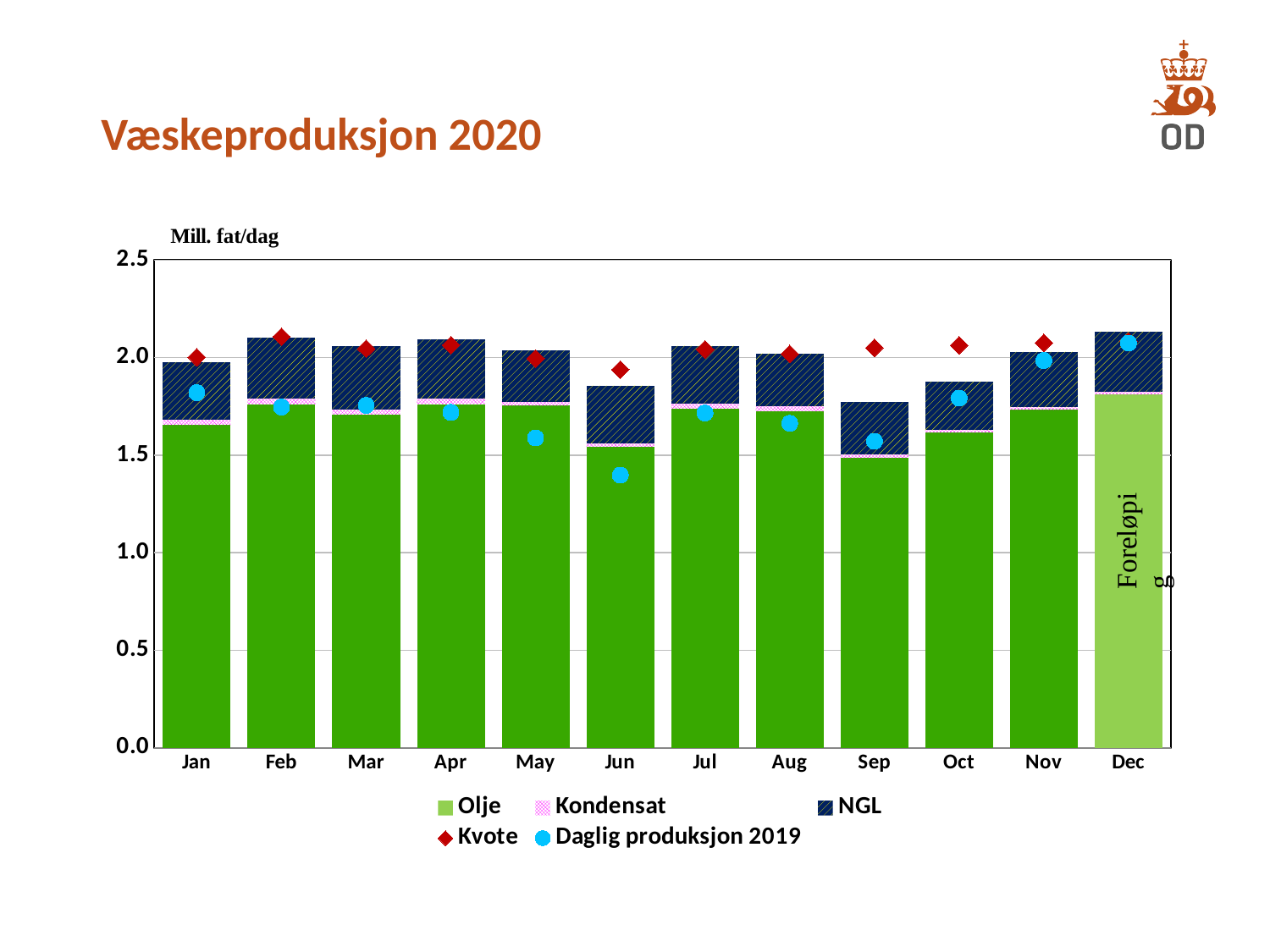
Is the total stacked bar for Dec greater or less than 2.0? greater Which month has the lowest value for Daglig produksjon 2019? Jun What unit is shown above the y axis of the chart? Mill. fat/dag Which month has the highest total stacked bar? Dec Which month has the highest value for Daglig produksjon 2019? Dec How many months are shown on the x axis of the chart? 12 What is the title of the chart? Væskeproduksjon 2020 How many series does the legend list? 5 Which has the larger total stacked bar, Feb or Jun? Feb What kind of chart is shown on the slide? Stacked bar chart Is the value for Daglig produksjon 2019 in Jun greater or less than 1.5? less Which month has the lowest total stacked bar? Sep